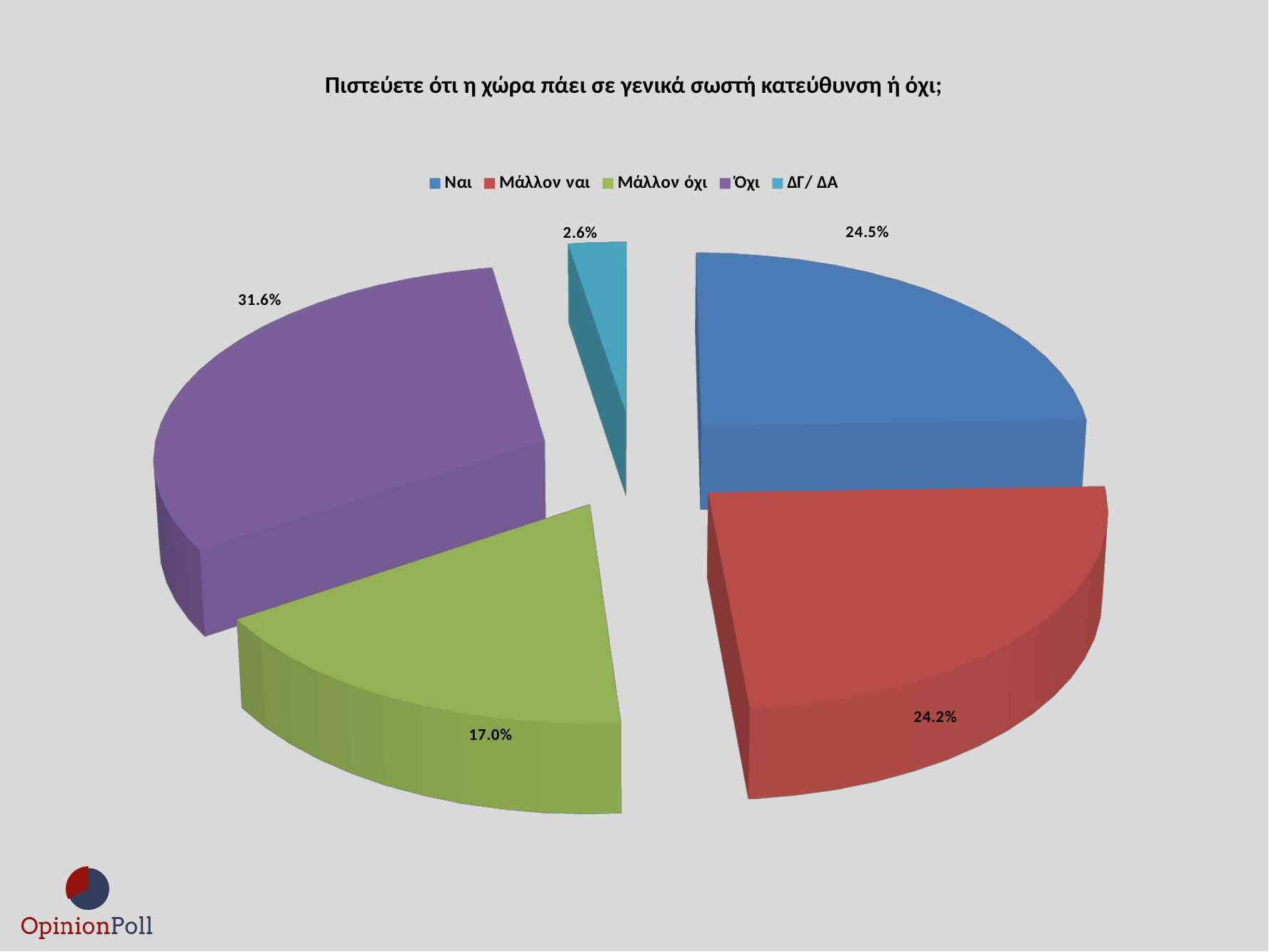
What is the difference in percentage points between Ναι and Μάλλον ναι? 0.3 What colour is the slice for Μάλλον ναι? red What percentage of respondents answered ΔΓ/ ΔΑ? 2.6% Which response has the largest share of the pie? Όχι How many slices does the pie chart have? 5 What percentage of respondents answered Όχι? 31.6% What percentage of respondents answered Ναι? 24.5% What percentage of respondents answered Μάλλον όχι? 17.0% What kind of chart is shown on the slide? pie chart What is the difference in percentage points between Όχι and Ναι? 7.1 Which response has the smallest share of the pie? ΔΓ/ ΔΑ Which is larger, the share for Όχι or the share for Μάλλον όχι? Όχι